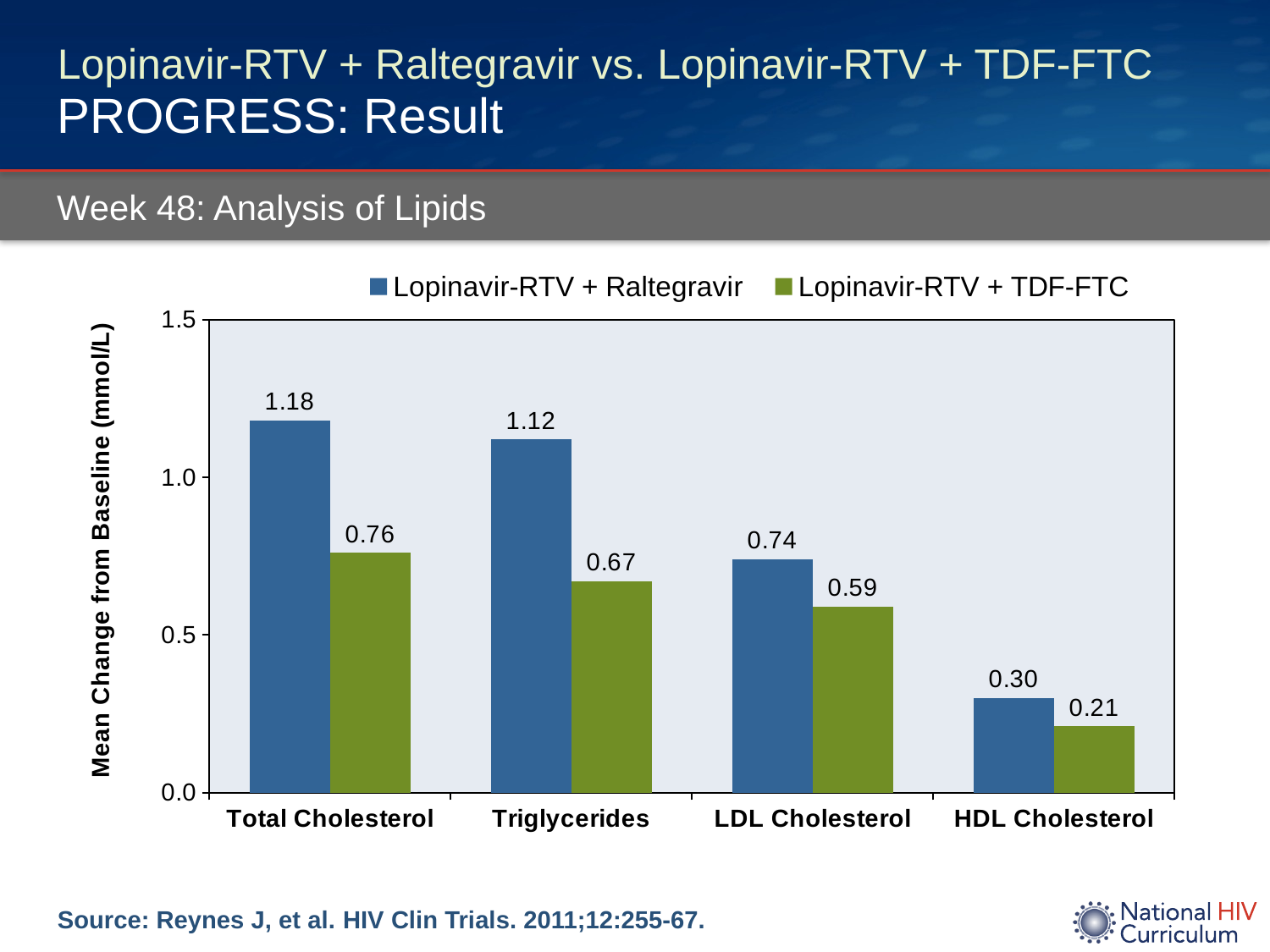
What is the mean change from baseline in Triglycerides for the Lopinavir-RTV + TDF-FTC group? 0.67 What is the mean change from baseline in Total Cholesterol for the Lopinavir-RTV + Raltegravir group? 1.18 How many lipid categories are shown on the x axis? 4 Which lipid category has the lowest value for the Lopinavir-RTV + Raltegravir group? HDL Cholesterol How many series does the legend list? 2 Which group has the larger mean change from baseline in Triglycerides? Lopinavir-RTV + Raltegravir Which lipid category has the highest value for the Lopinavir-RTV + TDF-FTC group? Total Cholesterol What is the mean change from baseline in HDL Cholesterol for the Lopinavir-RTV + Raltegravir group? 0.30 Is the value for HDL Cholesterol in the Lopinavir-RTV + TDF-FTC group greater or less than 0.5? less What kind of chart is shown on the slide? Bar chart What is the difference between the two groups' mean change in LDL Cholesterol? 0.15 What is the label of the y axis? Mean Change from Baseline (mmol/L)